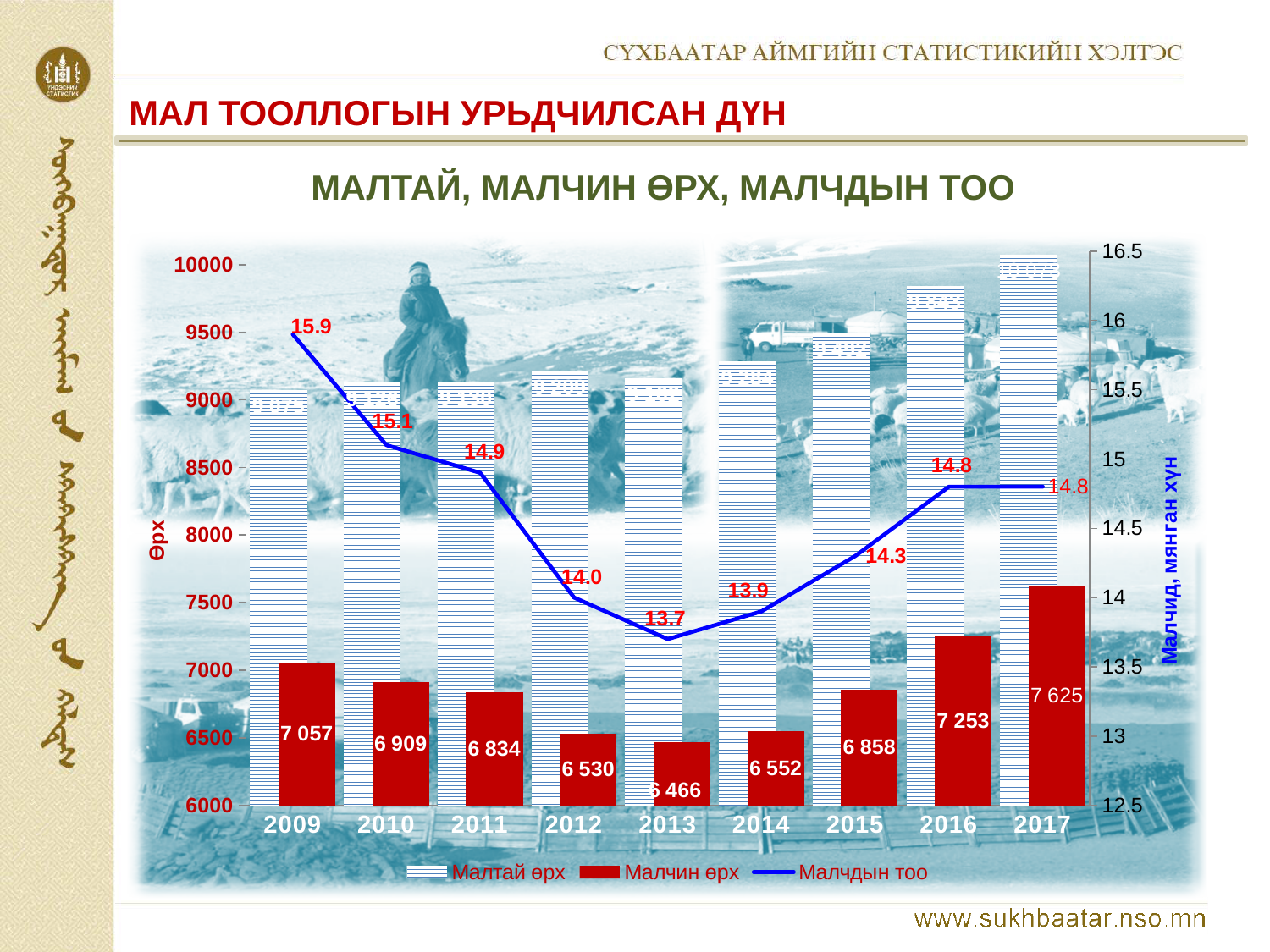
How many years are shown on the x axis? 9 What is the value of Малчдын тоо for 2013? 13.7 In which year is Малчин өрх highest? 2017 How many series does the legend list? 3 Does Малчдын тоо rise or fall from 2009 to 2013? fall What is the value of Малчин өрх for 2017? 7 625 In which year is Малчин өрх lowest? 2013 What is the value of Малчин өрх for 2009? 7 057 What is the difference between Малчин өрх in 2017 and in 2016? 372 Is the value of Малтай өрх for 2017 greater or less than 10000? greater Which is larger, Малчин өрх in 2010 or in 2015? 2010 What is the value of Малчдын тоо for 2009? 15.9